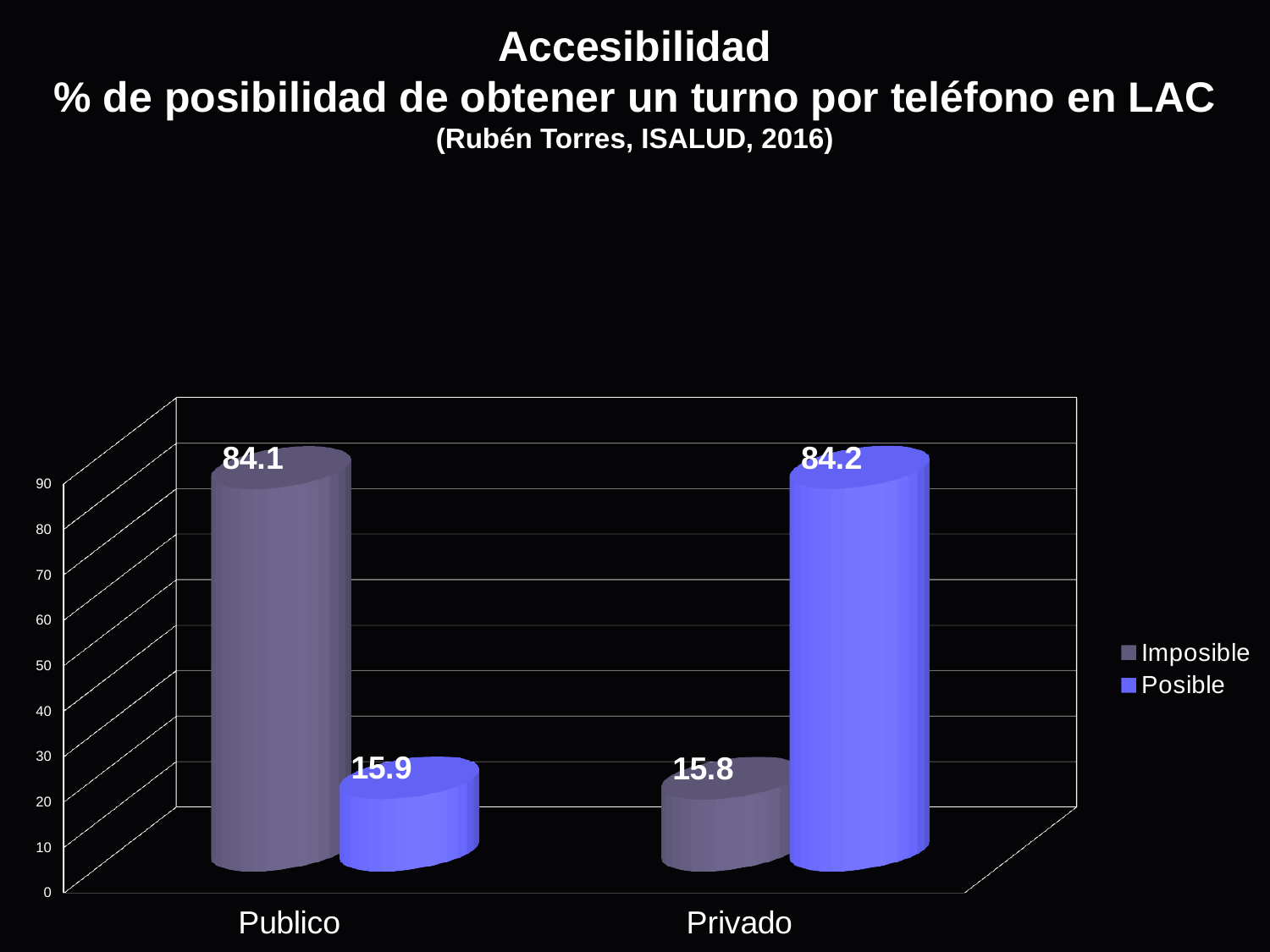
Which series is shown in blue according to the legend? Posible What kind of chart is shown on the slide? Bar chart What is the value for Posible in the Publico category? 15.9 What is the value for Imposible in the Publico category? 84.1 Which category has the highest value for the Posible series? Privado How many categories are shown on the x axis? 2 Which category has the lowest value for the Imposible series? Privado What is the value for Imposible in the Privado category? 15.8 How many series does the legend list? 2 What is the value for Posible in the Privado category? 84.2 What is the difference between the Imposible and Posible values for Publico? 68.2 Which is larger for Privado: Imposible or Posible? Posible